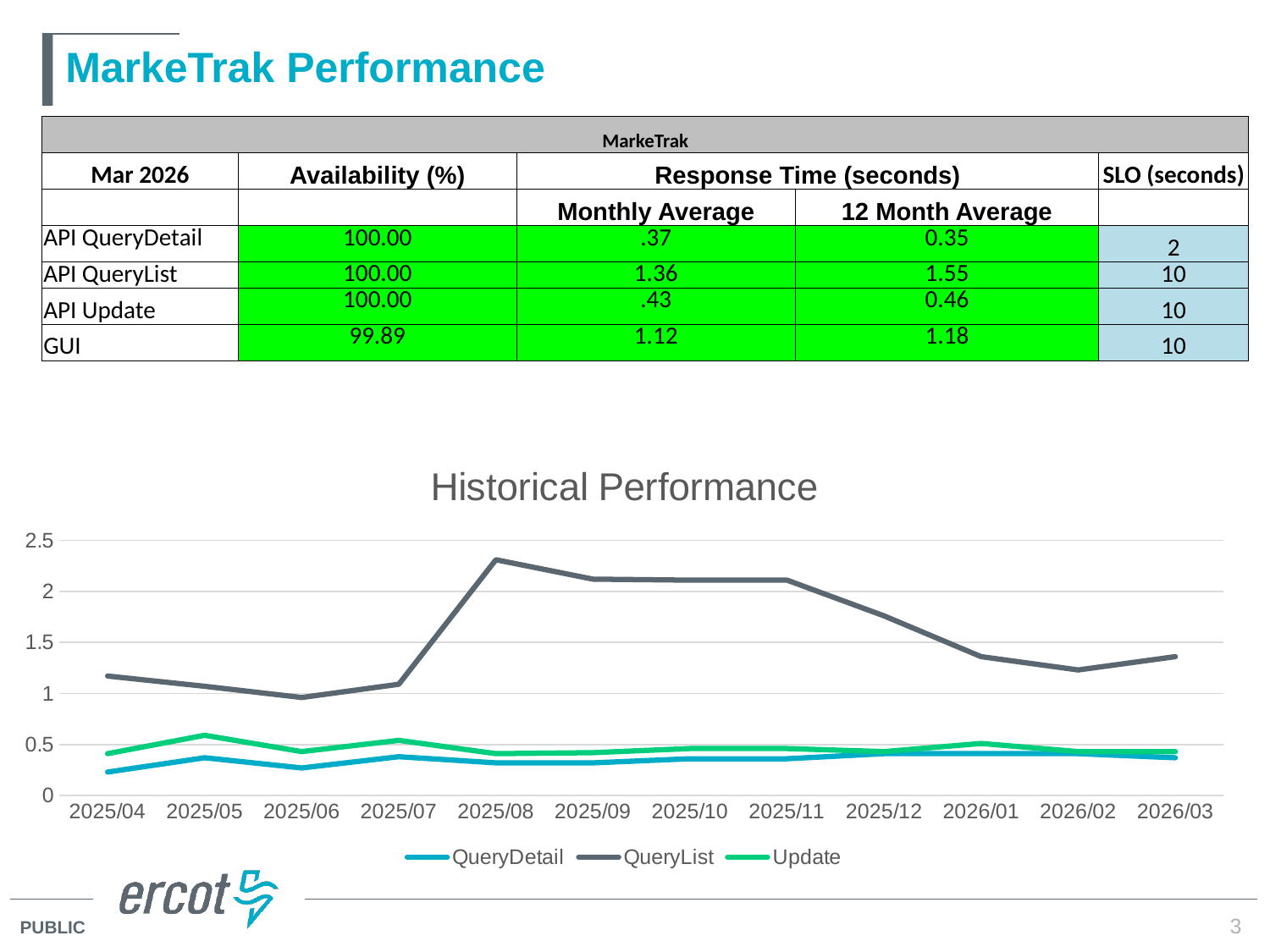
In the Historical Performance chart, which series is plotted with the dark grey line? QueryList What is the title of the line chart on the slide? Historical Performance How many series does the legend of the Historical Performance chart list? 3 In the Historical Performance chart, in which month does the QueryList series reach its highest value? 2025/08 In the Historical Performance chart, in which month is the QueryList series at its lowest value? 2025/06 What kind of chart is the Historical Performance chart? line chart In the Historical Performance chart, does the QueryList series rise or fall from 2025/08 to 2026/02? fall In the Historical Performance chart, is the QueryList value for 2026/01 greater or less than 1.5? less In the Historical Performance chart, is the QueryList value for 2025/08 greater or less than 2? greater In the Historical Performance chart, is the QueryDetail value for 2025/04 greater or less than 0.5? less In the Historical Performance chart, which series has the larger value in 2025/08, QueryList or QueryDetail? QueryList How many months are plotted along the x axis of the Historical Performance chart? 12